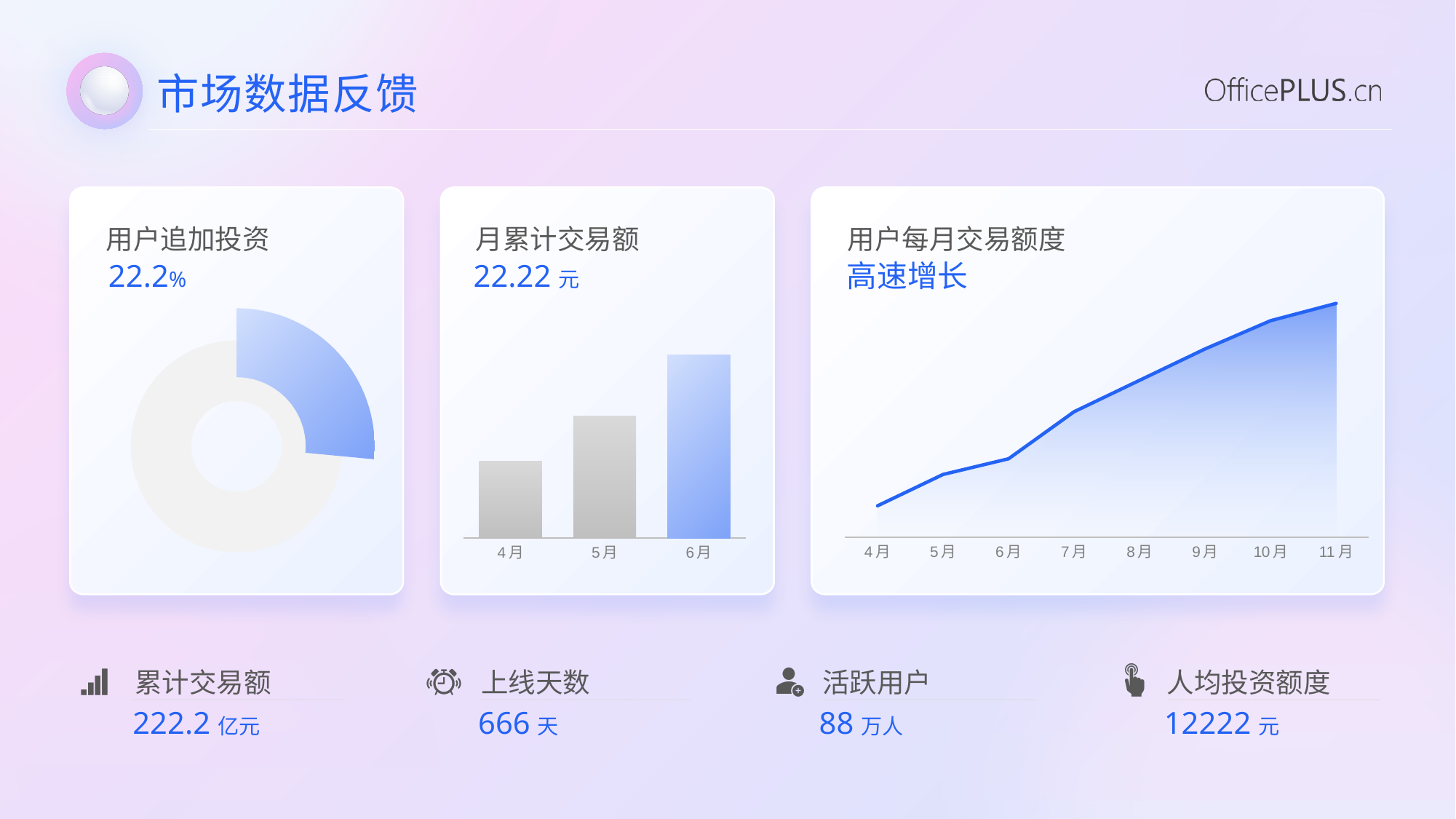
In the 月累计交易额 bar chart, which month has the lowest bar? 4月 What kind of chart is shown in the left panel titled 用户追加投资? Donut chart In the 月累计交易额 bar chart, which month has the highest bar? 6月 In the 用户每月交易额度 line chart, how many months are shown on the x axis? 8 In the 月累计交易额 bar chart, which bar is taller, 4月 or 5月? 5月 What kind of chart is shown in the middle panel titled 月累计交易额? Bar chart In the 月累计交易额 bar chart, how many months are shown on the x axis? 3 In the 用户每月交易额度 line chart, which month is the first on the x axis? 4月 What kind of chart is shown in the right panel titled 用户每月交易额度? Line chart In the 月累计交易额 bar chart, which bar is coloured blue rather than grey? 6月 In the 用户每月交易额度 line chart, do the values rise or fall from 4月 to 11月? Rise